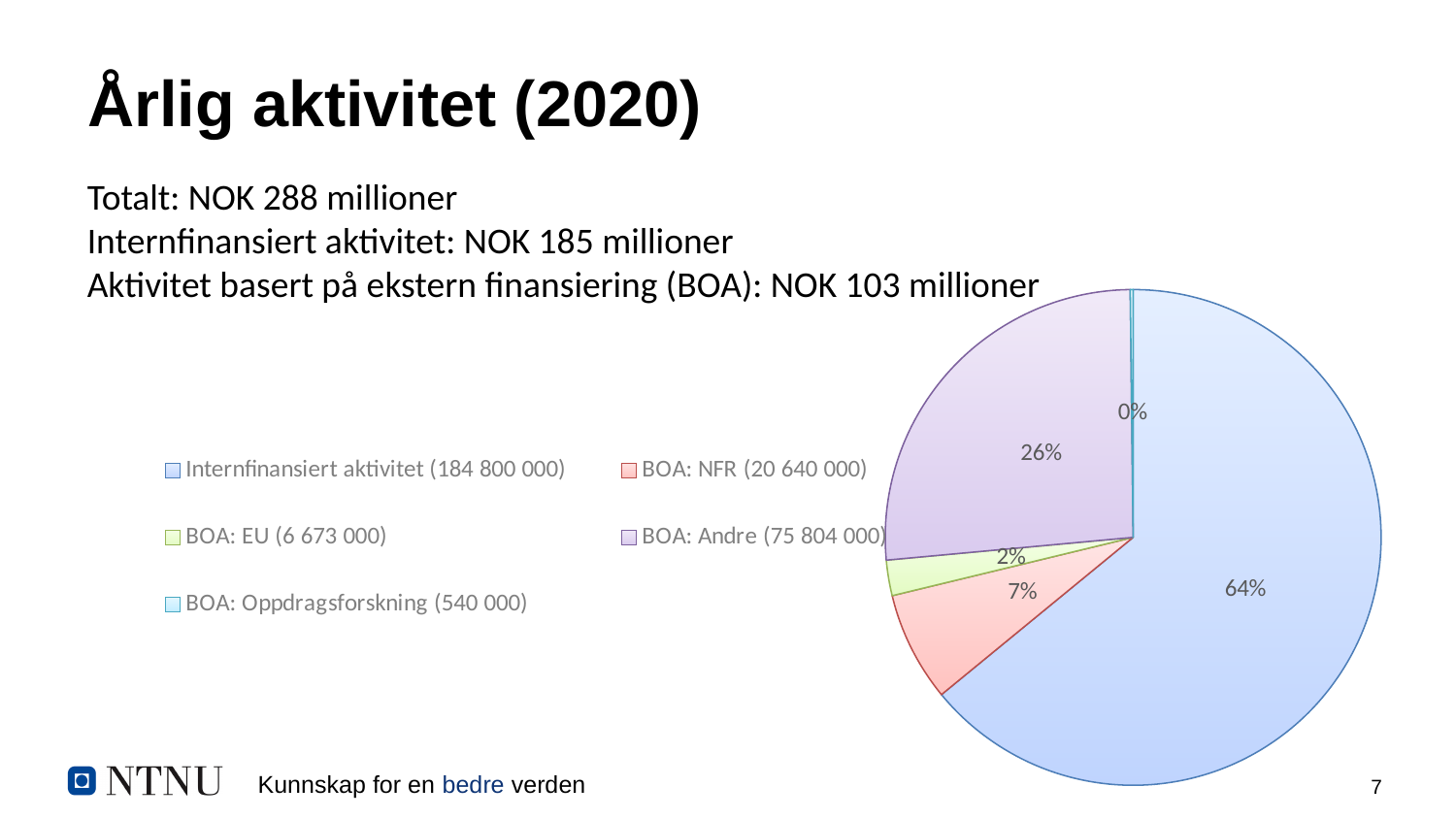
What share of the pie does BOA: Andre represent? 26% What share of the pie does BOA: NFR represent? 7% Which category has the largest slice of the pie? Internfinansiert aktivitet Which is larger, the share for BOA: Andre or the share for BOA: NFR? BOA: Andre What value is given in the legend for BOA: NFR? 20 640 000 Which category has the smallest slice of the pie? BOA: Oppdragsforskning What share of the pie does Internfinansiert aktivitet represent? 64% What is the difference in percentage points between the Internfinansiert aktivitet share and the BOA: Andre share? 38 percentage points What kind of chart is shown on the slide? pie chart What percentage label is shown for BOA: Oppdragsforskning? 0% How many slices does the pie chart have? 5